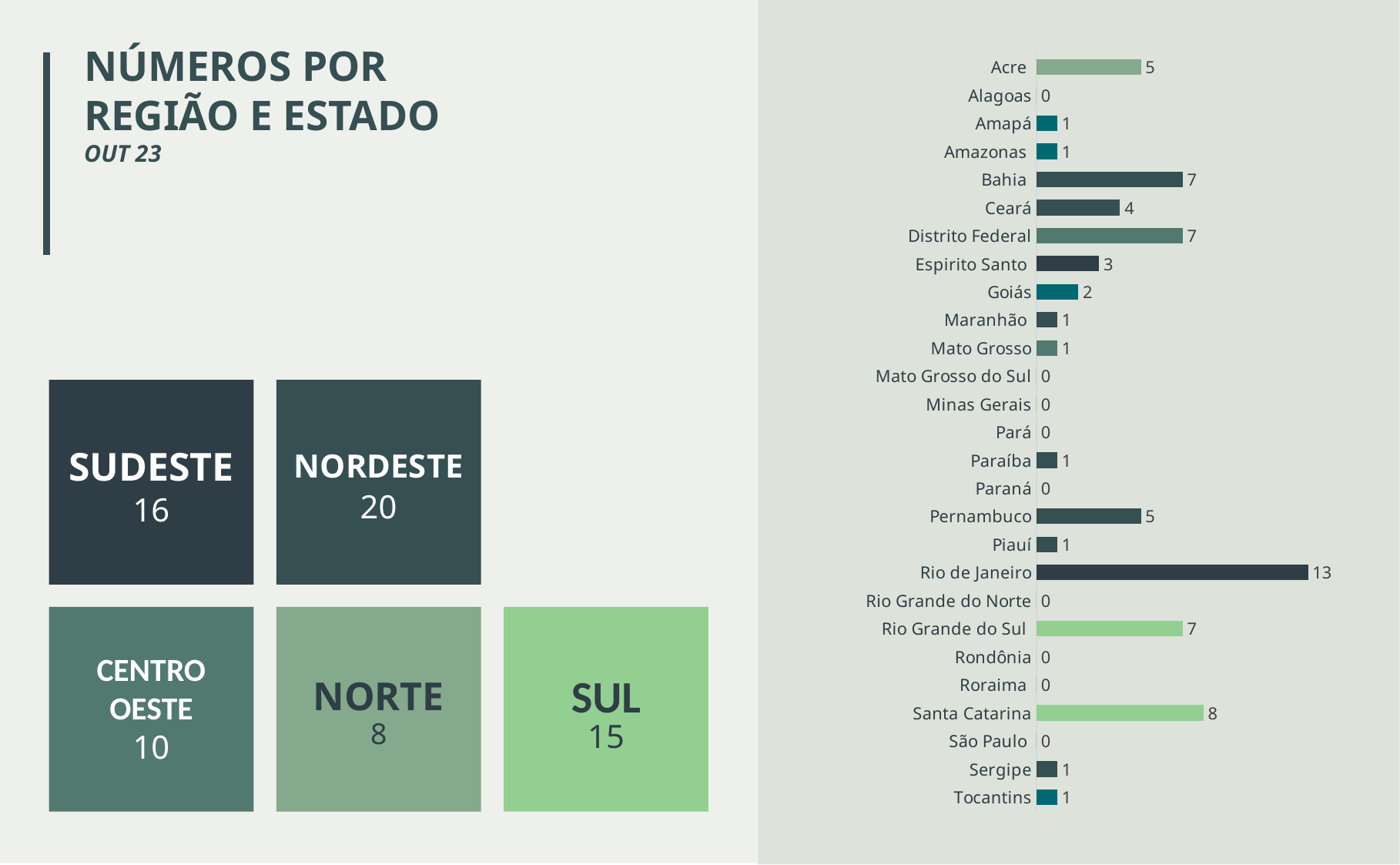
What is the difference between the values for Rio de Janeiro and Santa Catarina? 5 Which state has the highest value in the bar chart? Rio de Janeiro What is the value for Distrito Federal in the bar chart? 7 What is the value for Santa Catarina in the bar chart? 8 Which has a larger value, Pernambuco or Rio Grande do Sul? Rio Grande do Sul Which has a larger value, Acre or Goiás? Acre What is the value for Espirito Santo in the bar chart? 3 What is the difference between the values for Bahia and Ceará? 3 What is the value for Rio de Janeiro in the bar chart? 13 How many states in the bar chart have a value of 0? 9 How many states are listed in the bar chart? 27 What type of chart is shown on the right side of the slide? bar chart